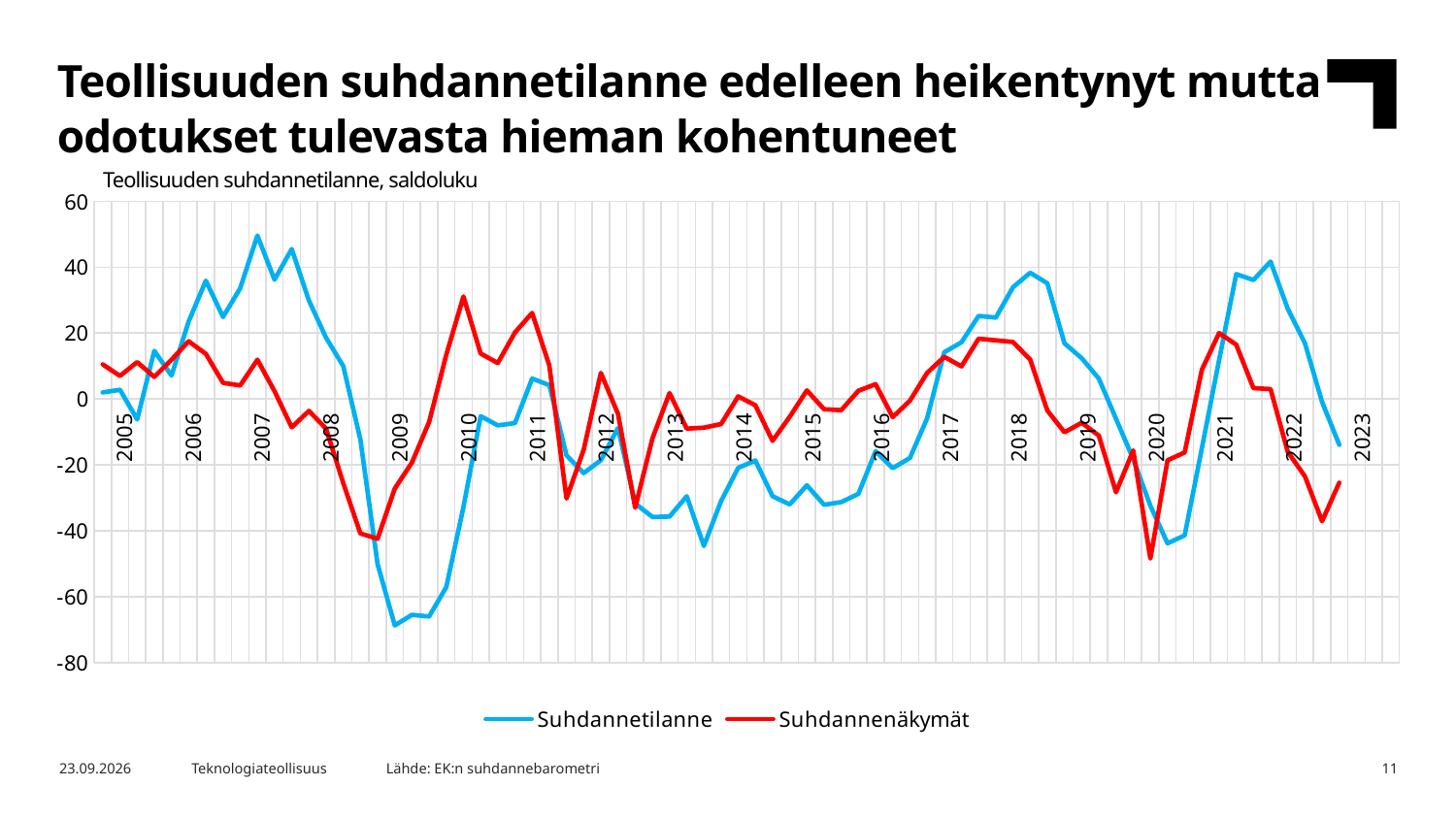
What are the two series named in the legend? Suhdannetilanne and Suhdannenäkymät Is the lowest value of the Suhdannetilanne series, reached around 2009, greater or less than -60? less Is the lowest value of the Suhdannenäkymät series around 2020 greater or less than -40? less Around 2009, which series reaches the lower value, Suhdannetilanne or Suhdannenäkymät? Suhdannetilanne Is the peak value of the Suhdannetilanne series around 2007 greater or less than 40? greater How many year labels are shown on the x axis? 19 What kind of chart is shown on the slide? line chart What is the title of the chart? Teollisuuden suhdannetilanne, saldoluku How many series does the legend list? 2 Around 2007, which series reaches the higher value, Suhdannetilanne or Suhdannenäkymät? Suhdannetilanne Does the Suhdannetilanne series rise or fall from its 2021 peak to 2023? fall